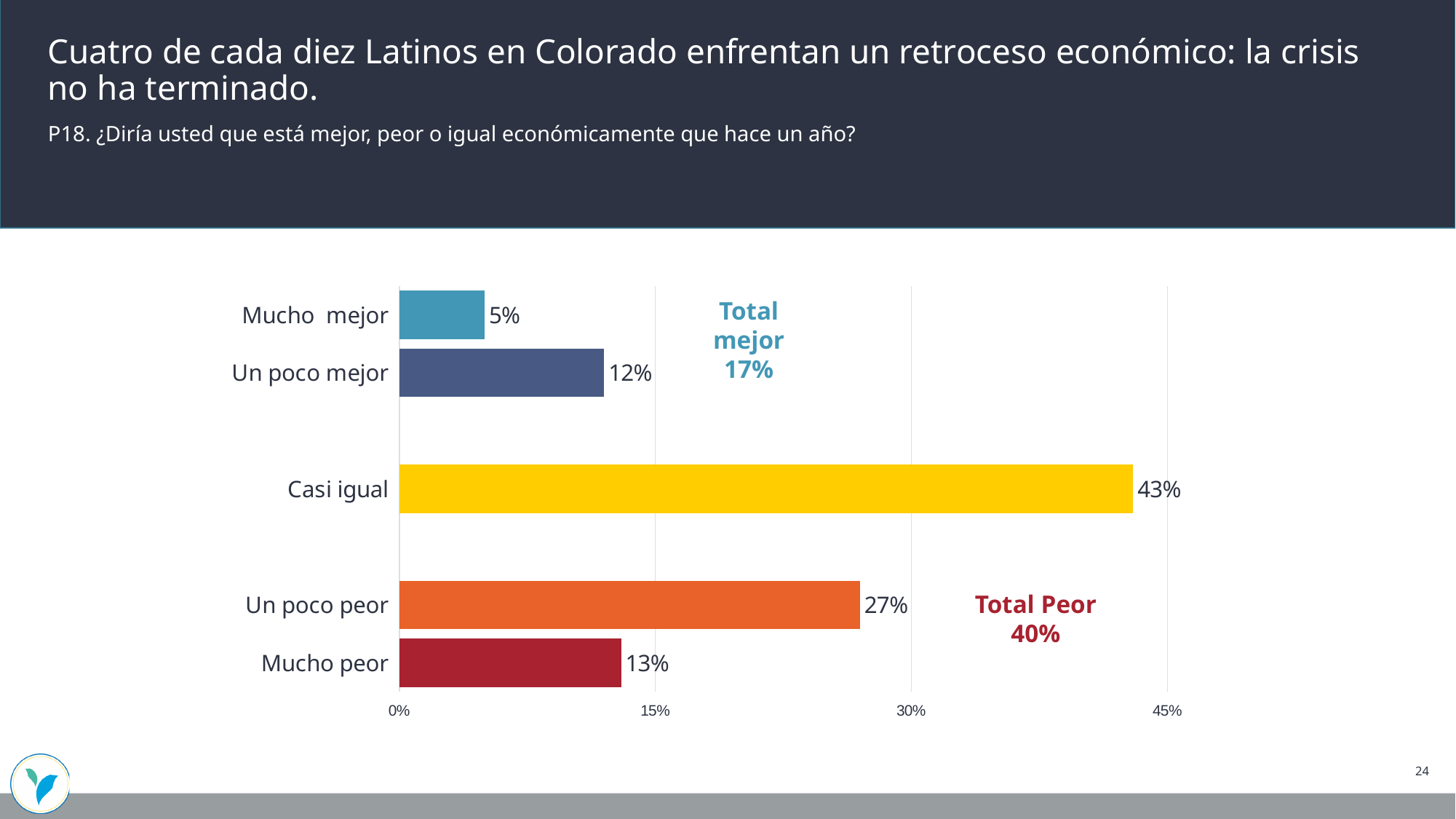
What is the value for "Un poco peor"? 27% What kind of chart is shown on the slide? bar chart Which is larger, "Mucho peor" or "Un poco mejor"? Mucho peor How many categories are shown in the chart? 5 Which category has the lowest value? Mucho mejor What is the value for "Casi igual"? 43% What is the difference between "Un poco peor" and "Un poco mejor"? 15% Which category has the highest value? Casi igual What is the "Total Peor" figure annotated on the chart? 40% What is the value for "Mucho peor"? 13% Is the value for "Casi igual" greater or less than 30%? greater What is the value for "Mucho mejor"? 5%